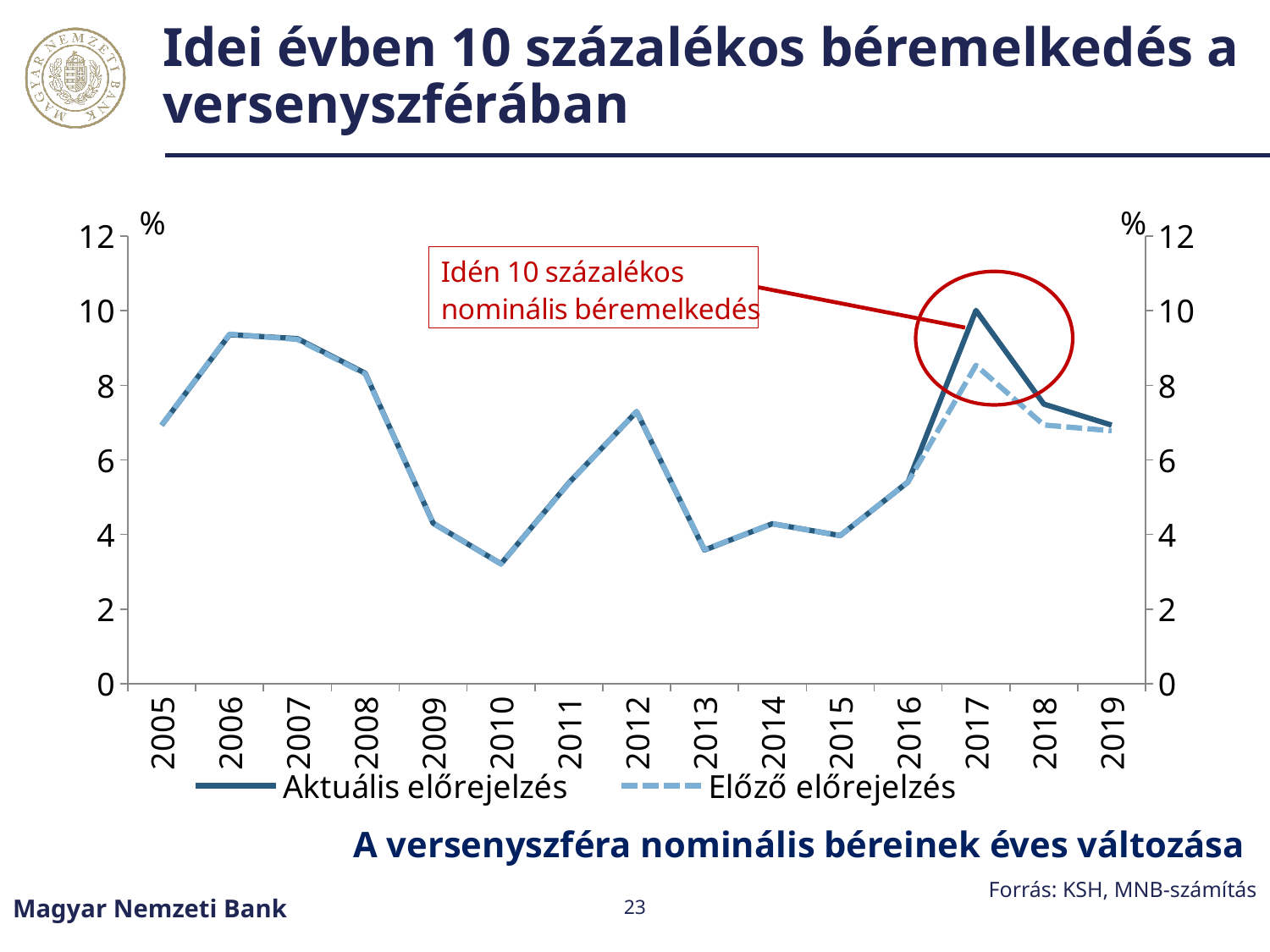
Is the Előző előrejelzés value for 2017 greater or less than 8? greater Which series has the higher value in 2017, Aktuális előrejelzés or Előző előrejelzés? Aktuális előrejelzés In which year does the Aktuális előrejelzés series reach its highest value? 2017 What is the value of the Aktuális előrejelzés series in 2017? 10 What is the title of the chart? A versenyszféra nominális béreinek éves változása Is the value for 2010 greater or less than 4? less How many series does the legend list? 2 Is the value for 2006 greater or less than 8? greater Do the values rise or fall between 2006 and 2010? fall How many years are shown on the x axis? 15 In which year is the lowest value on the chart? 2010 What kind of chart is shown on the slide? line chart